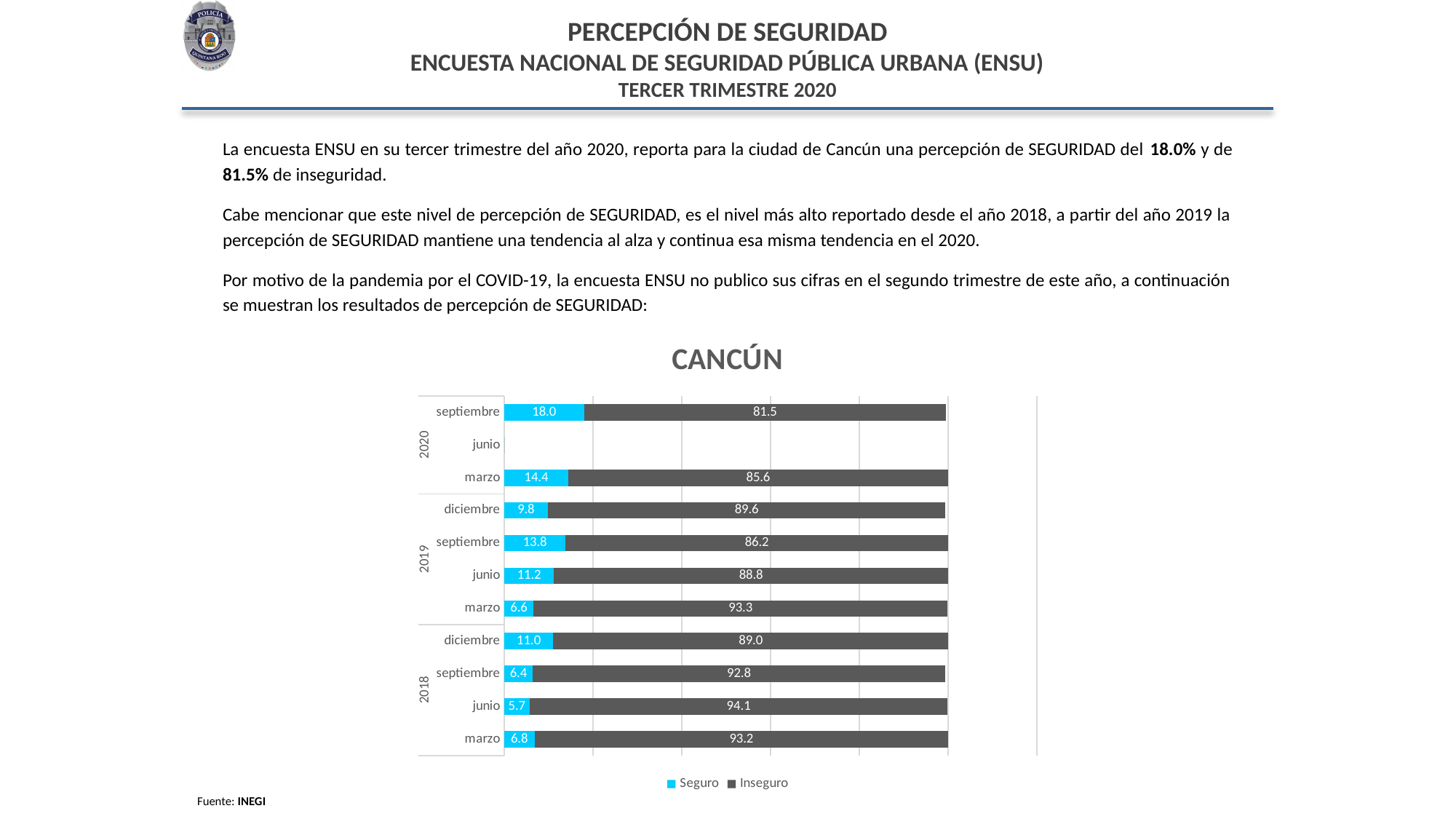
What is the Inseguro value for marzo 2019? 93.3 What is the Inseguro value for junio 2019? 88.8 Which period in the chart has no bar plotted? junio 2020 How many series does the legend list? 2 Which period has the highest Seguro value? septiembre 2020 What is the difference between the Seguro values for septiembre 2020 and marzo 2020? 3.6 What kind of chart is shown? Stacked bar chart What is the Seguro value for diciembre 2018? 11.0 What is the total of the stacked bar for septiembre 2018? 99.2 What is the Seguro value for septiembre 2020? 18.0 Which period has the lowest Seguro value? junio 2018 Which is larger, the Seguro value for diciembre 2019 or for septiembre 2019? septiembre 2019